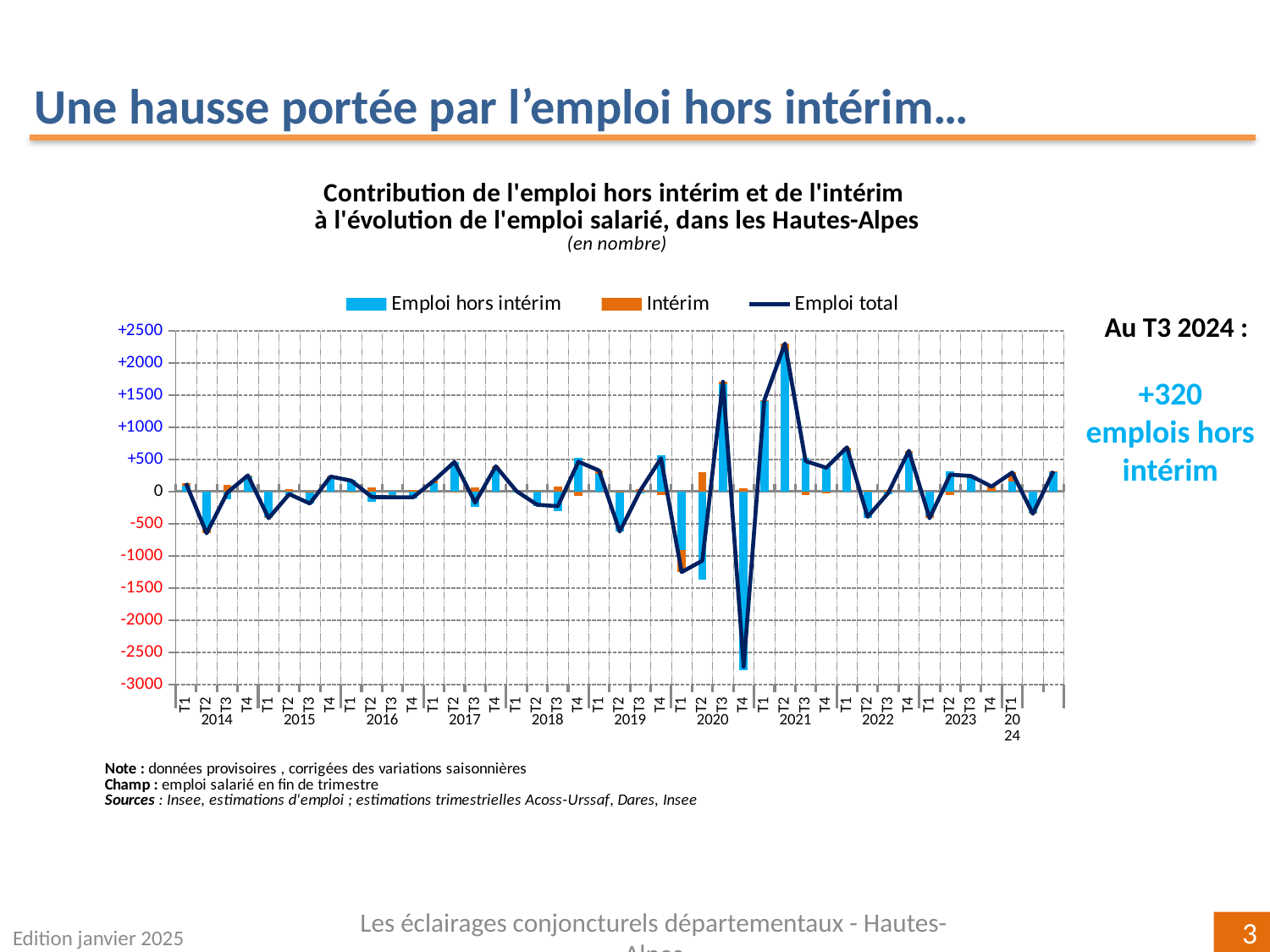
In which quarter does the Emploi total line reach its lowest point? T4 2020 What kind of chart is shown on the slide? A combined bar and line chart Which is larger, the Emploi hors intérim value for T2 2021 or for T3 2020? T2 2021 According to the slide, what was the change in emplois hors intérim at T3 2024? +320 In which quarter does the Emploi total line reach its highest point? T2 2021 Is the Emploi hors intérim value for T1 2020 greater or less than -1000? greater Is the Emploi hors intérim value for T4 2020 greater or less than -2500? less What is the lowest value shown on the chart's vertical axis? -3000 How many series does the chart legend list? 3 Is the Emploi hors intérim value for T2 2021 greater or less than +2000? greater How many years are labelled along the x axis of the chart? 11 Which series is drawn as a line rather than bars? Emploi total